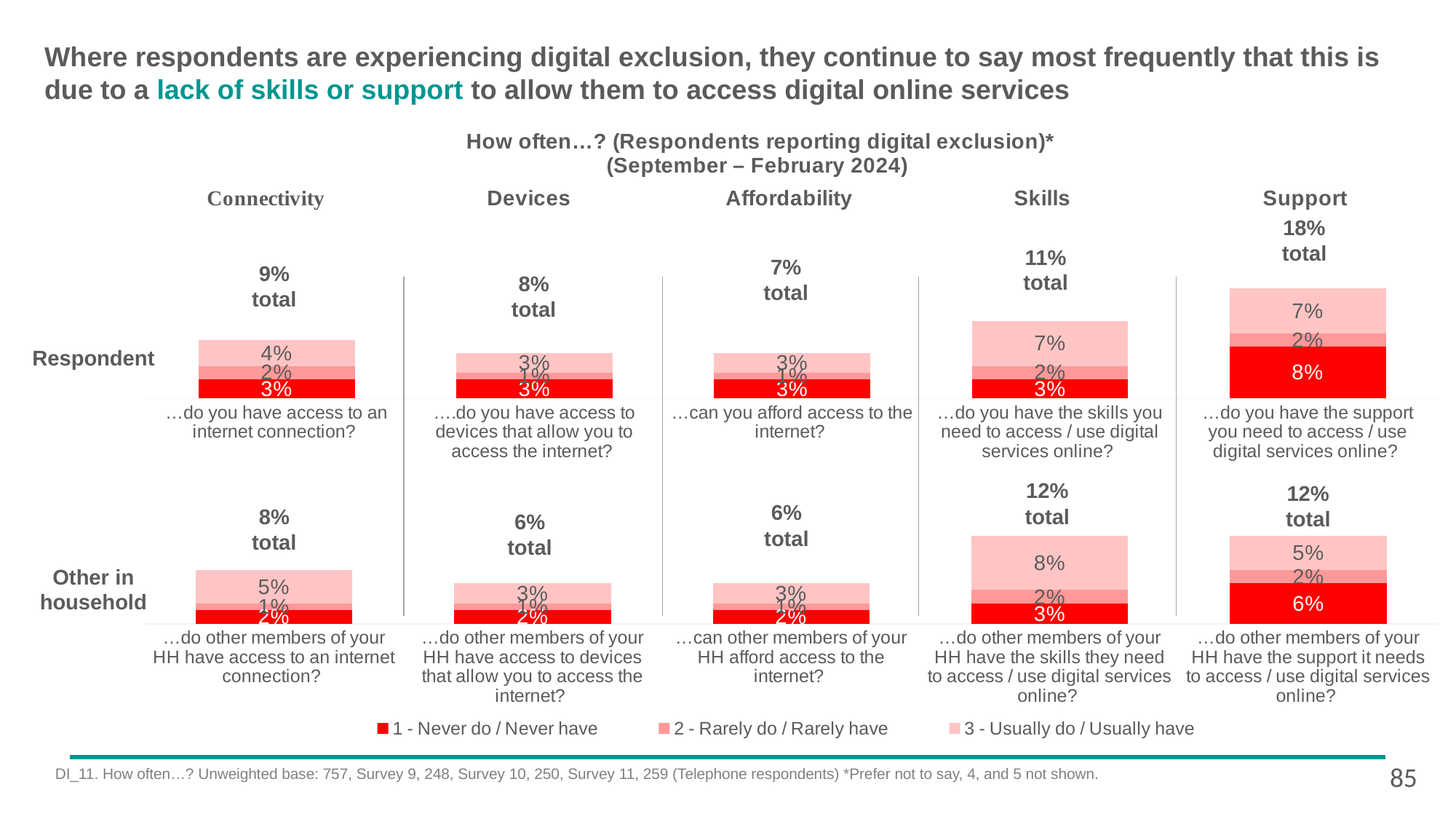
In the Other in household row, what is the '1 - Never do / Never have' value for Support? 6% In the Respondent row, which of the five categories has the highest total? Support Is the Respondent total for Connectivity larger or smaller than the Other in household total for Connectivity? larger What is the difference between the Respondent total for Support (18%) and the Respondent total for Skills (11%)? 7% Which legend entry is shown in the darkest red colour? 1 - Never do / Never have How many categories (Connectivity, Devices, etc.) are shown across the top of the chart? 5 In the Other in household row, which category has the lowest total, Connectivity or Devices? Devices What kind of chart is used to show the Respondent and Other in household results? Stacked bar chart In the Respondent row, what percentage of respondents say they never have the skills they need to access / use digital services online? 3% In the Other in household row, what is the '3 - Usually do / Usually have' value for Skills? 8% How many series does the legend list? 3 In the Respondent row, what is the total percentage shown for Support? 18%